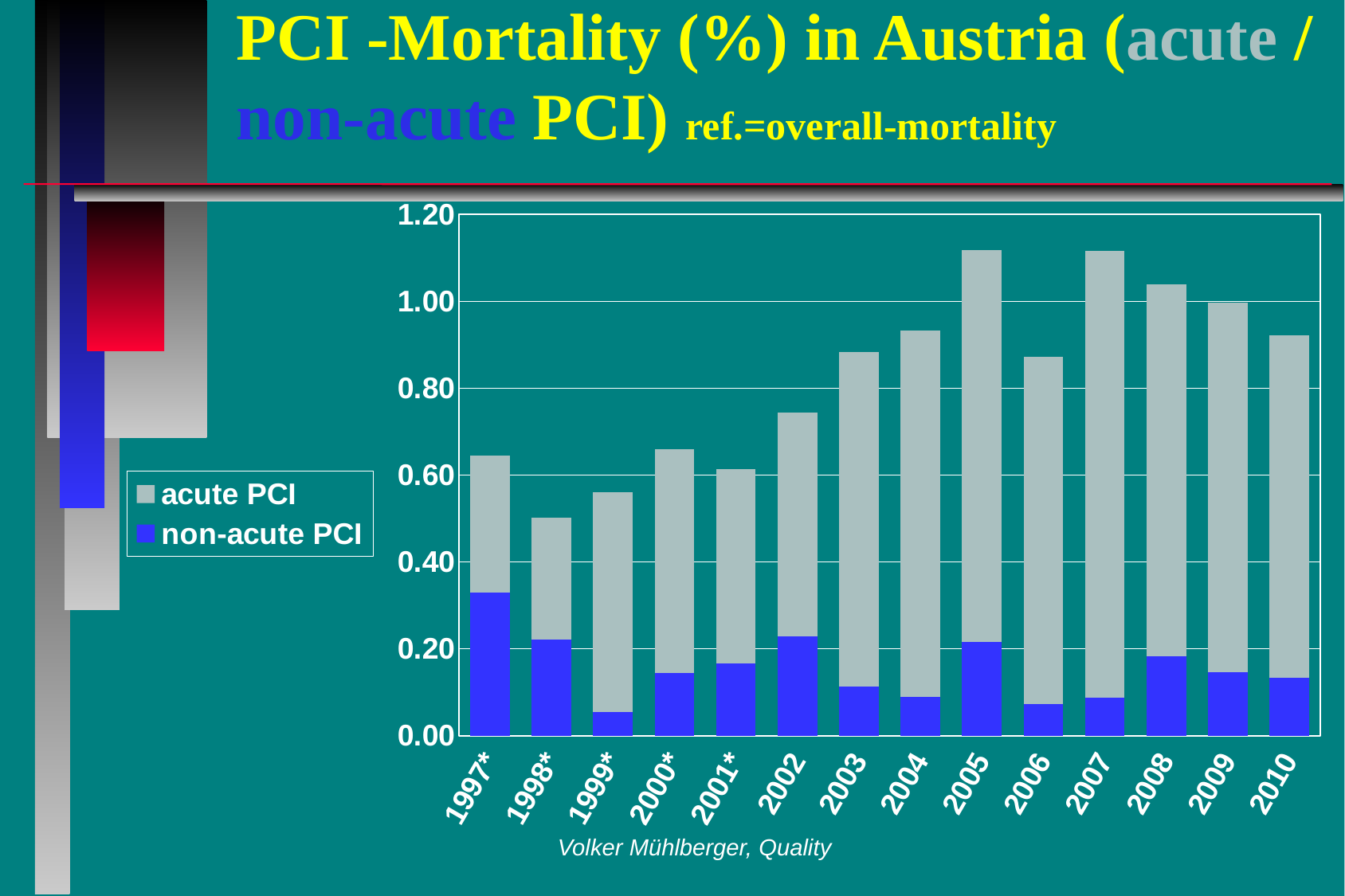
How many years are shown on the x axis? 14 Which series is shown in blue? non-acute PCI What kind of chart is shown on the slide? stacked bar chart Is the total bar height for 2006 greater or less than 0.80? greater Is the total bar height for 2010 greater or less than 1.00? less Which year has the lowest total bar? 1998* How many series does the legend list? 2 Which year has the highest non-acute PCI mortality? 1997* Which year has the lowest non-acute PCI mortality? 1999* Is the non-acute PCI value for 1997* greater or less than 0.20? greater Which has the larger total bar, 2002 or 2003? 2003